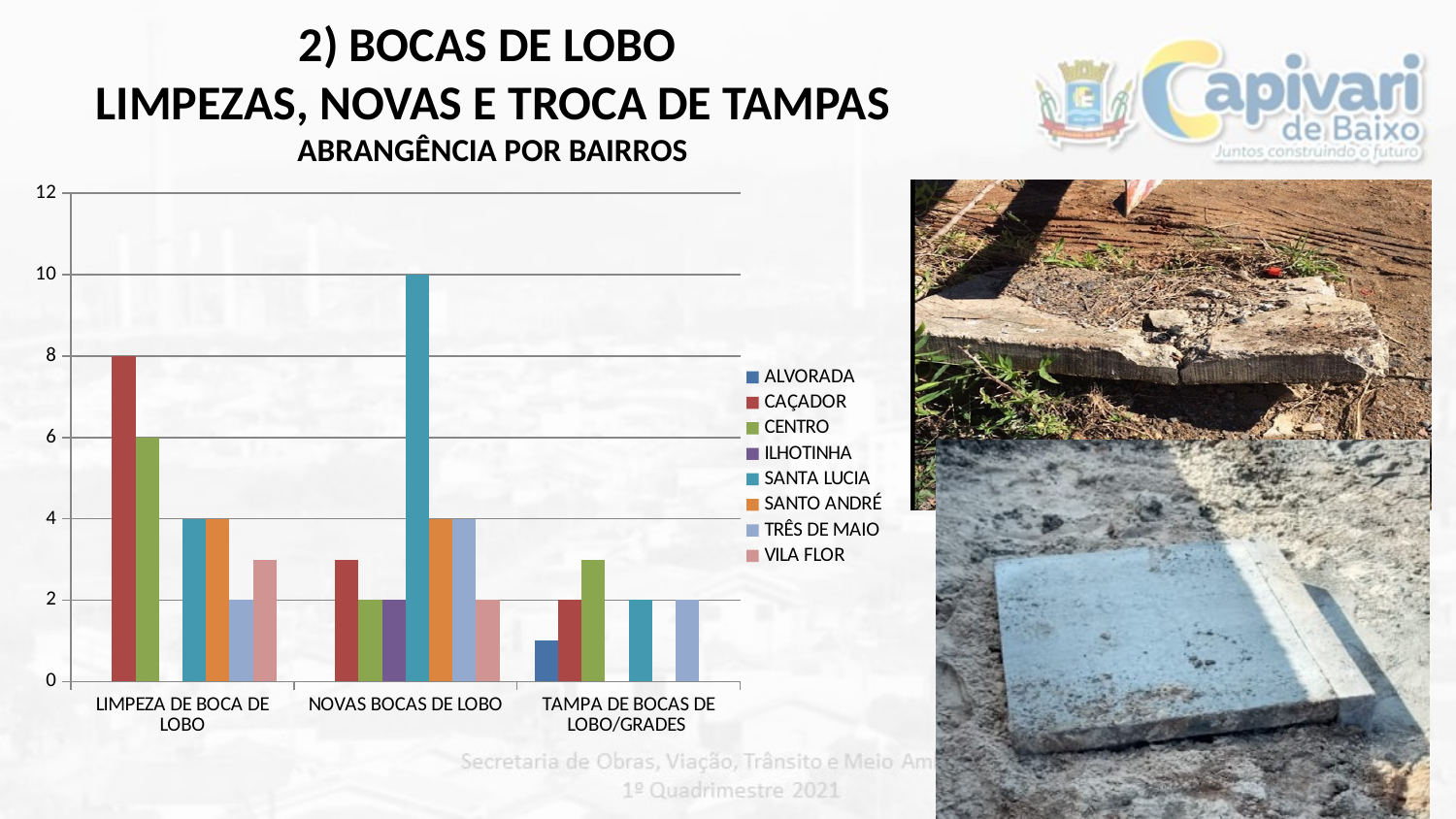
Which series is shown in the legend directly below CENTRO? ILHOTINHA Which is larger: SANTA LUCIA in NOVAS BOCAS DE LOBO or CAÇADOR in LIMPEZA DE BOCA DE LOBO? SANTA LUCIA in NOVAS BOCAS DE LOBO What is the value for CENTRO in the LIMPEZA DE BOCA DE LOBO category? 6 Which series has the highest bar in the NOVAS BOCAS DE LOBO category? SANTA LUCIA Is the value for VILA FLOR in the LIMPEZA DE BOCA DE LOBO category greater or less than 4? less Which series has the highest bar in the LIMPEZA DE BOCA DE LOBO category? CAÇADOR How many categories are shown on the x axis of the chart? 3 What is the value for CAÇADOR in the LIMPEZA DE BOCA DE LOBO category? 8 What type of chart is shown on the slide? bar chart What is the difference between the CAÇADOR and CENTRO values in the LIMPEZA DE BOCA DE LOBO category? 2 How many series does the chart legend list? 8 What is the value for SANTA LUCIA in the NOVAS BOCAS DE LOBO category? 10